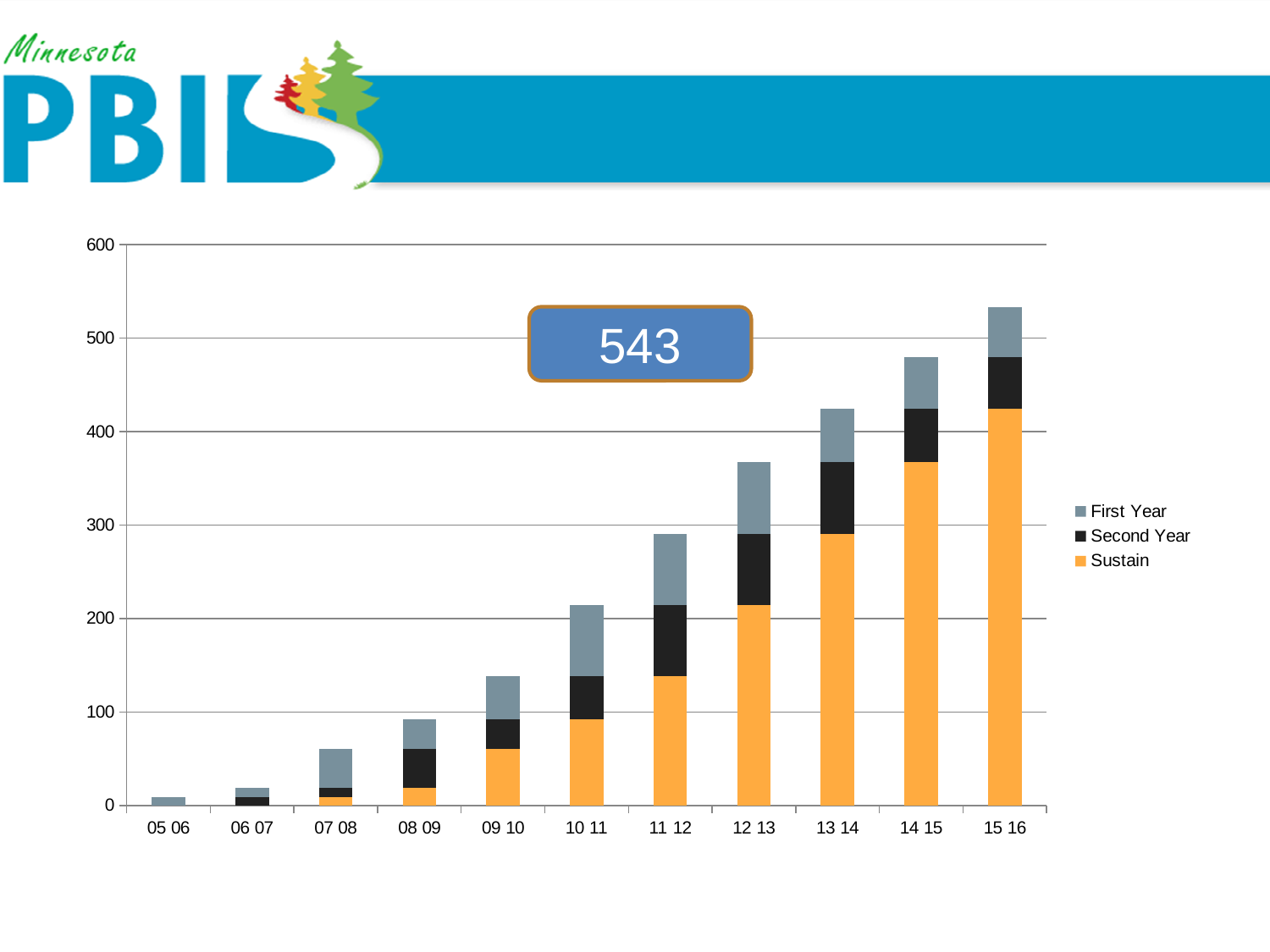
Which school year has the tallest stacked bar? 15 16 Which has the larger total stacked bar, 13 14 or 11 12? 13 14 How many school-year categories are shown on the x axis? 11 How many series does the legend list? 3 Is the total stacked bar for 09 10 greater or less than 200? less Is the Sustain segment for 14 15 greater or less than 300? greater What number is shown in the callout box above the chart? 543 Do the stacked bar totals rise or fall from 05 06 to 15 16? rise What are the three series named in the legend? First Year, Second Year, Sustain Which school year has the shortest stacked bar? 05 06 What kind of chart is shown on the slide? bar chart Is the total stacked bar for 15 16 greater or less than 500? greater